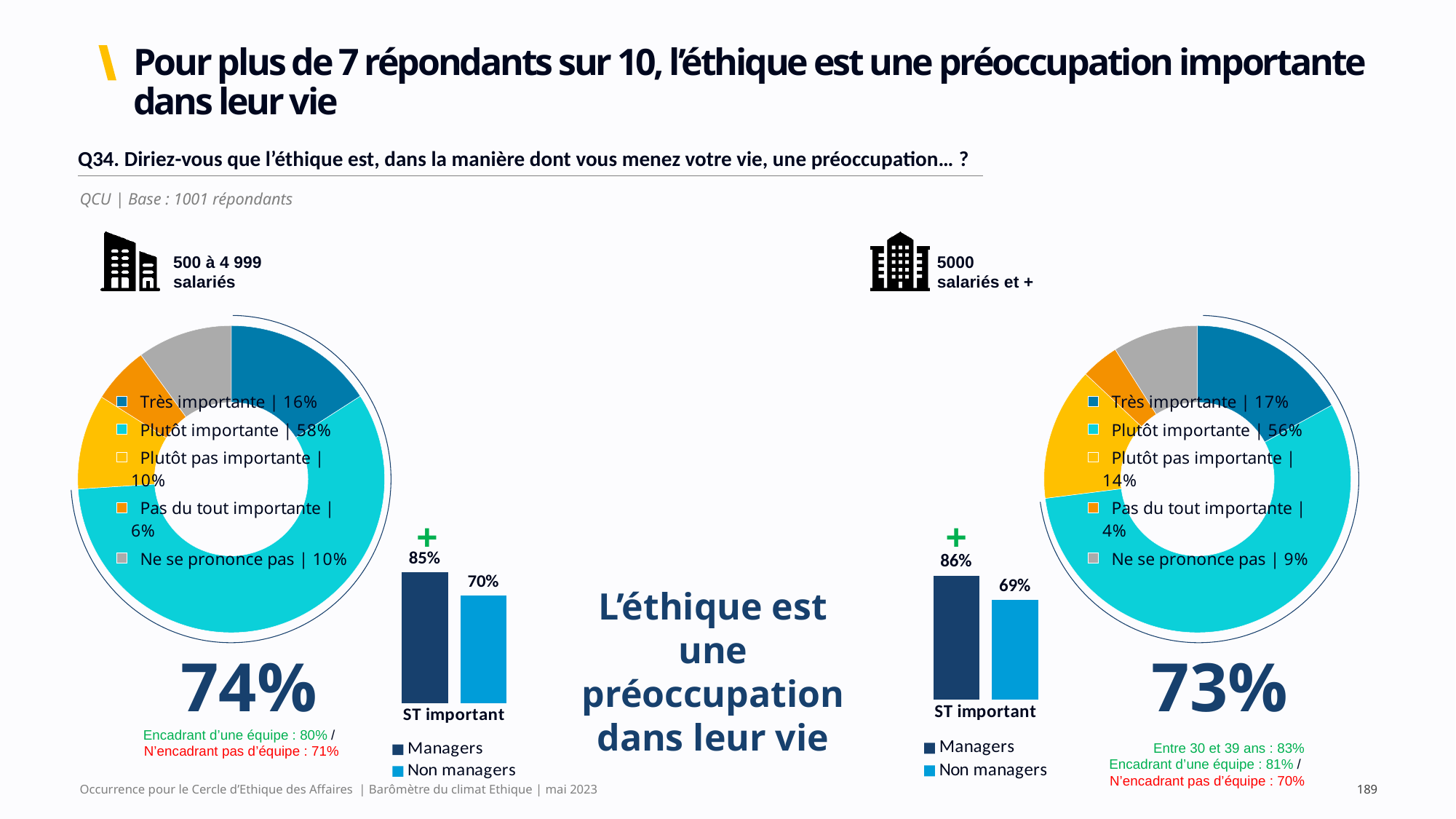
In the donut chart for '5000 salariés et +', which category has the smallest share? Pas du tout importante How many series does the legend of the 'ST important' bar chart for '500 à 4 999 salariés' list? 2 In the donut chart for '500 à 4 999 salariés', which category has the largest share? Plutôt importante What kind of chart is used to show the 'ST important' values for Managers and Non managers? Bar chart In the donut chart for '5000 salariés et +', what is the value for 'Plutôt pas importante'? 14% In the donut chart for '500 à 4 999 salariés', what is the difference between 'Très importante' and 'Pas du tout importante'? 10% In the 'ST important' bar chart for '5000 salariés et +', what is the value for Non managers? 69% In the 'ST important' bar chart for '500 à 4 999 salariés', what is the value for Managers? 85% In the donut chart for '5000 salariés et +', which is larger: 'Très importante' or 'Ne se prononce pas'? Très importante In the donut chart for '500 à 4 999 salariés', what is the value for 'Plutôt importante'? 58% In the 'ST important' bar chart for '5000 salariés et +', what is the difference between Managers and Non managers? 17% How many categories does the donut chart for '500 à 4 999 salariés' show? 5